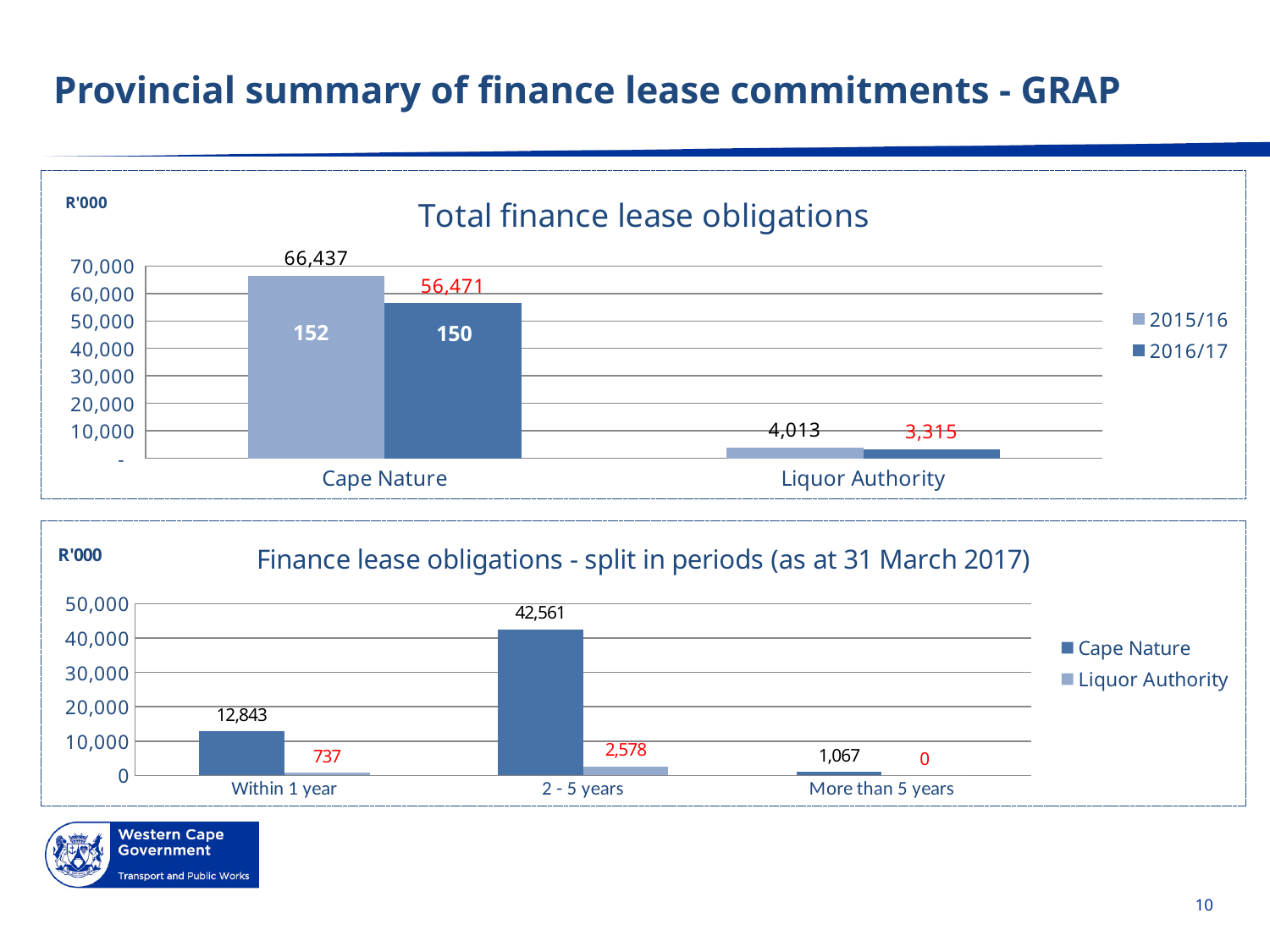
In the 'Total finance lease obligations' chart, what is the difference between the 2015/16 and 2016/17 values for Cape Nature? 9,966 In the 'Total finance lease obligations' chart, which category has the lowest 2016/17 value? Liquor Authority In the 'Total finance lease obligations' chart, what is the 2016/17 value for Liquor Authority? 3,315 In the 'Total finance lease obligations' chart, how many series does the legend list? 2 In the 'Finance lease obligations - split in periods' chart, how many period categories are shown on the x axis? 3 In the 'Finance lease obligations - split in periods' chart, what is the difference between the Cape Nature and Liquor Authority values for 2 - 5 years? 39,983 In the 'Total finance lease obligations' chart, what number is printed inside the 2016/17 bar for Cape Nature? 150 In the 'Total finance lease obligations' chart, what is the 2015/16 value for Cape Nature? 66,437 In the 'Finance lease obligations - split in periods' chart, what is the Cape Nature value for 2 - 5 years? 42,561 In the 'Finance lease obligations - split in periods' chart, which period has the highest Cape Nature value? 2 - 5 years In the 'Finance lease obligations - split in periods' chart, what is the Liquor Authority value for Within 1 year? 737 What type of chart is the 'Finance lease obligations - split in periods' chart? Bar chart